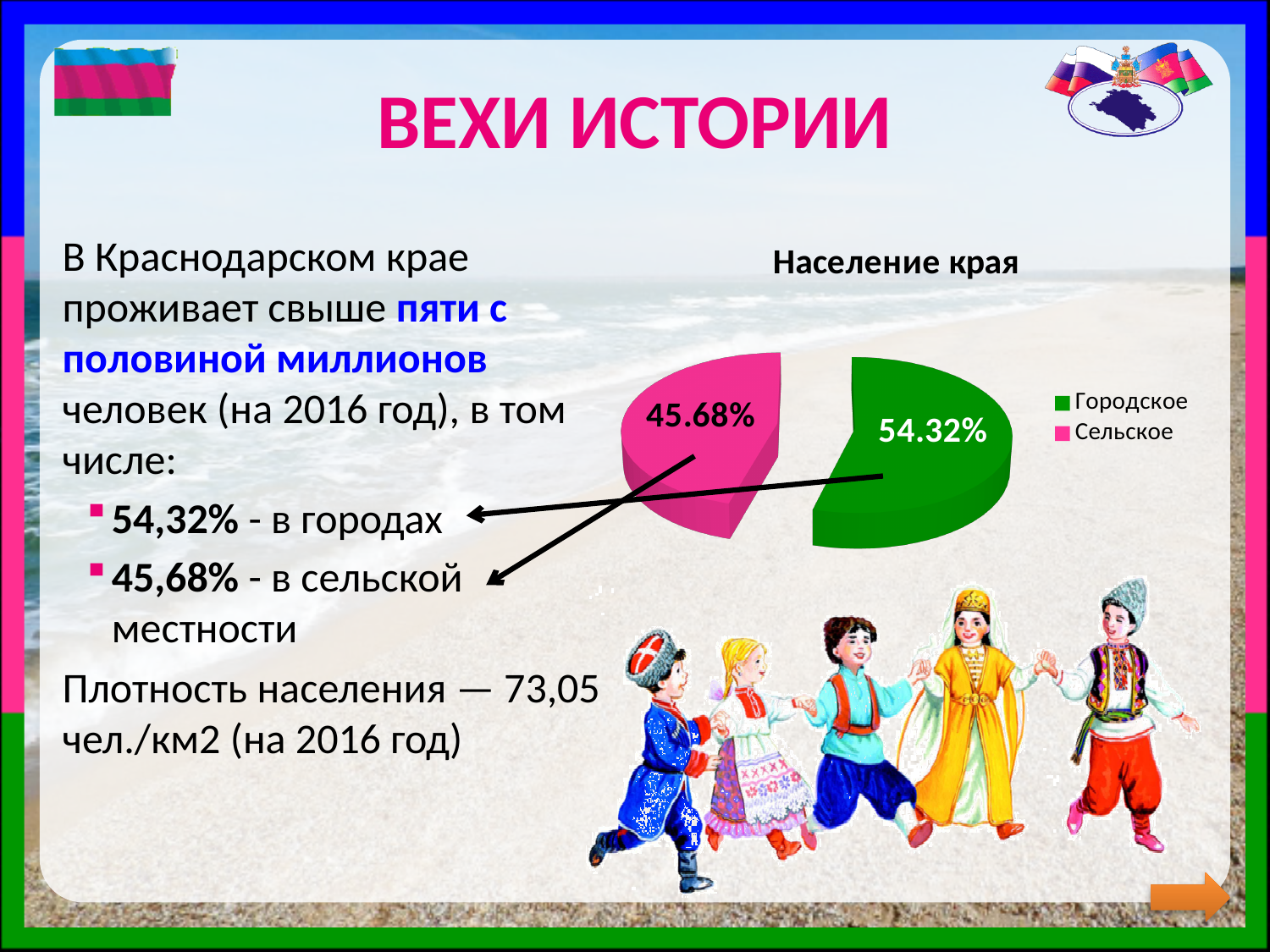
Is the value for Сельское greater or less than 50%? less Which slice of the pie is the largest? Городское What share of the pie does Городское have? 54.32% Which slice of the pie is the smallest? Сельское What share of the pie does Сельское have? 45.68% Which is larger, Городское or Сельское? Городское What is the title of the chart? Население края What is the difference between the Городское and Сельское shares? 8.64% What colour is the Сельское slice? pink How many entries does the legend list? 2 How many slices does the pie chart have? 2 What type of chart is shown on the slide? pie chart